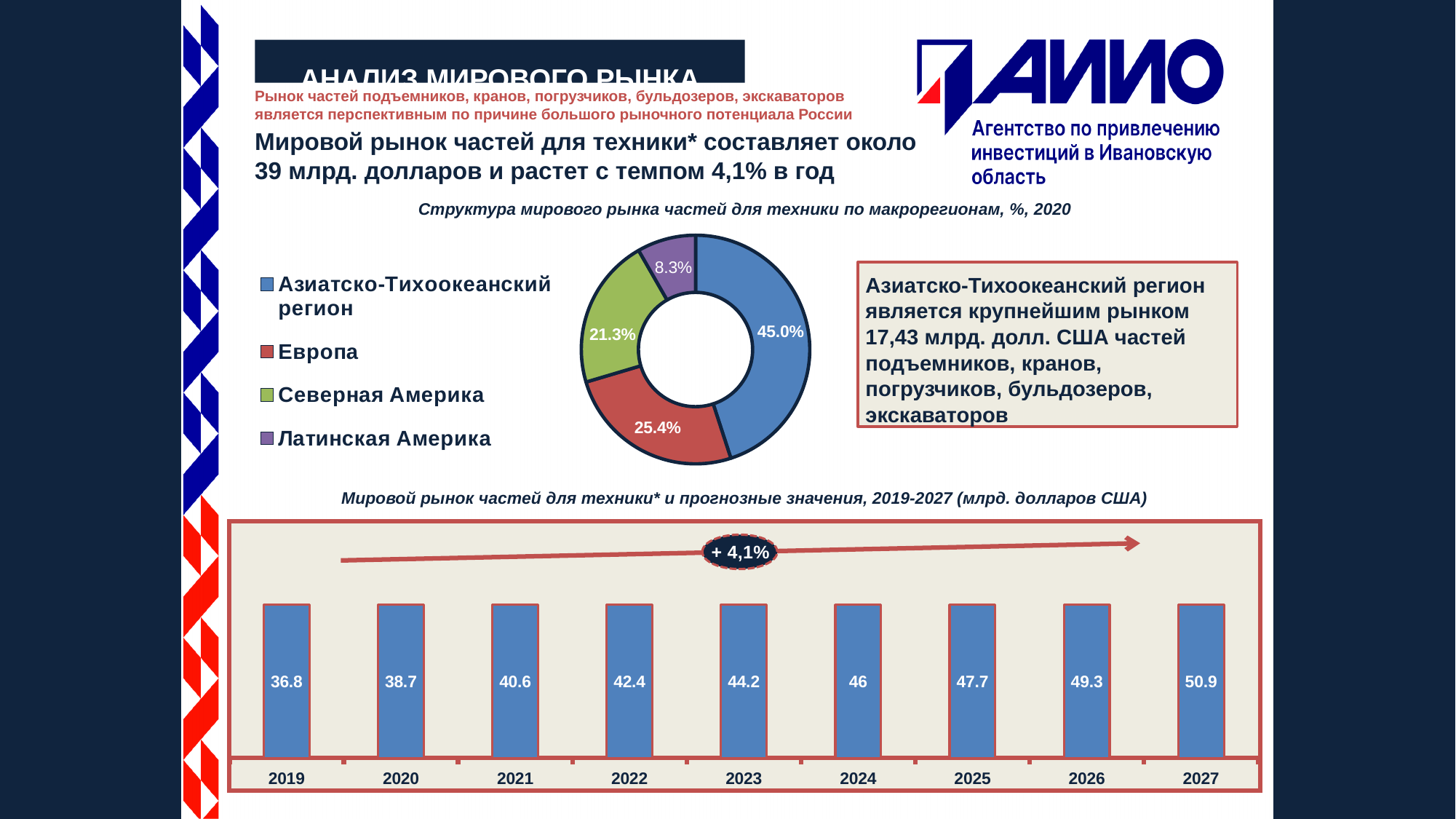
In the bar chart 'Мировой рынок частей для техники* и прогнозные значения, 2019-2027', what is the value for 2027? 50.9 In the bar chart 'Мировой рынок частей для техники* и прогнозные значения, 2019-2027', what is the value for 2023? 44.2 In the bar chart 'Мировой рынок частей для техники* и прогнозные значения, 2019-2027', which is larger, the value for 2021 or the value for 2025? 2025 In the donut chart 'Структура мирового рынка частей для техники по макрорегионам, %, 2020', what share does Европа have? 25.4% What type of chart is the upper chart 'Структура мирового рынка частей для техники по макрорегионам, %, 2020'? Pie (donut) chart In the donut chart 'Структура мирового рынка частей для техники по макрорегионам, %, 2020', which region has the smallest share? Латинская Америка In the bar chart 'Мировой рынок частей для техники* и прогнозные значения, 2019-2027', do the labelled values rise or fall from 2019 to 2027? Rise In the bar chart 'Мировой рынок частей для техники* и прогнозные значения, 2019-2027', what is the difference between the values for 2027 and 2019? 14.1 In the donut chart 'Структура мирового рынка частей для техники по макрорегионам, %, 2020', how many regions are shown? 4 In the donut chart 'Структура мирового рынка частей для техники по макрорегионам, %, 2020', which region has the largest share? Азиатско-Тихоокеанский регион In the donut chart 'Структура мирового рынка частей для техники по макрорегионам, %, 2020', what is the difference between the shares of Северная Америка and Латинская Америка? 13.0% In the bar chart 'Мировой рынок частей для техники* и прогнозные значения, 2019-2027', how many years are shown? 9